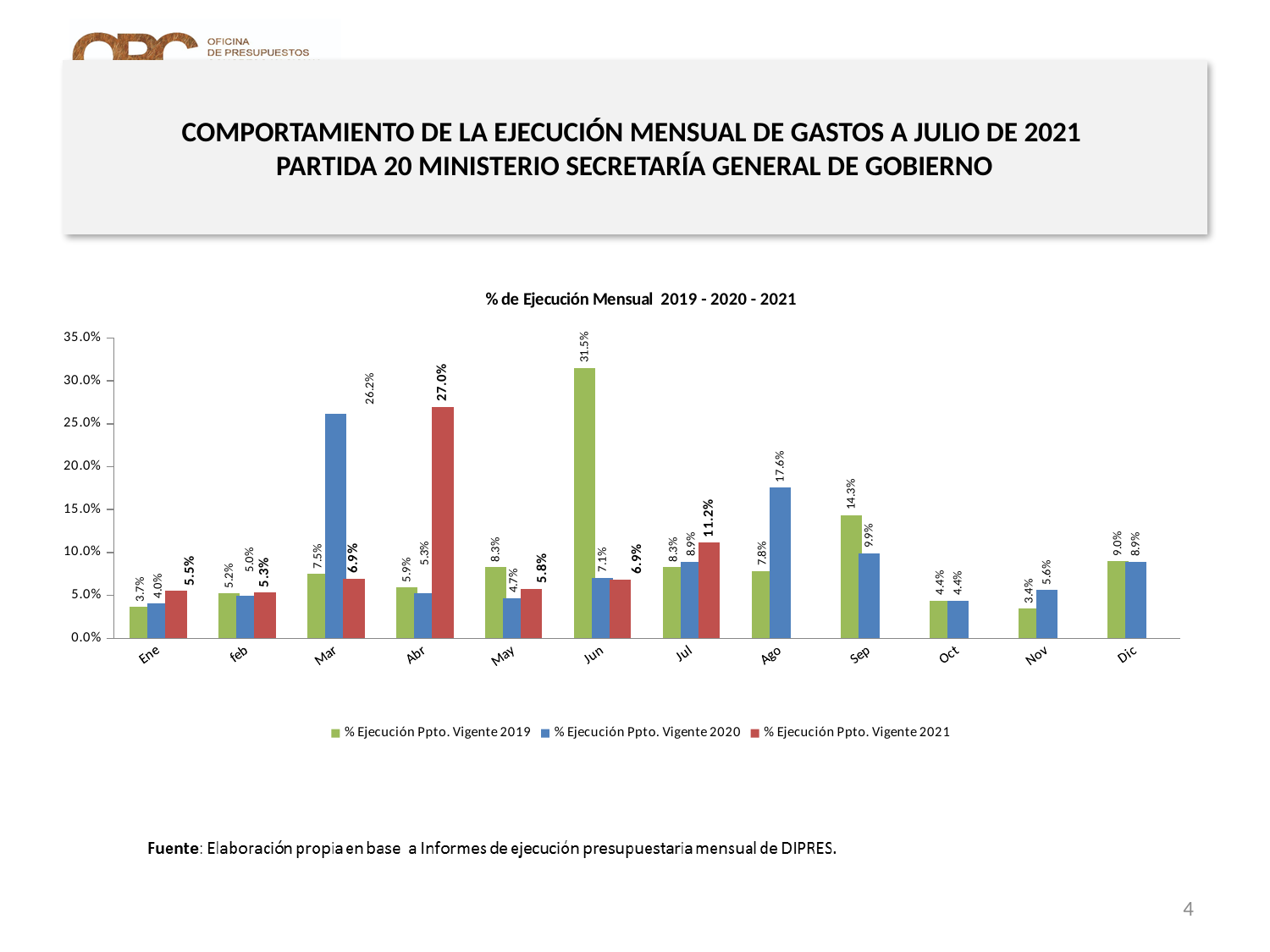
What is the value for % Ejecución Ppto. Vigente 2019 in Sep? 14.3% In which month is the % Ejecución Ppto. Vigente 2019 series lowest? Nov What is the value for % Ejecución Ppto. Vigente 2020 in Mar? 26.2% What is the value for % Ejecución Ppto. Vigente 2021 in Abr? 27.0% How many series does the legend list? 3 Which is larger in Jul: the 2021 value or the 2020 value? 2021 value (11.2%) What is the title of the chart? % de Ejecución Mensual 2019 - 2020 - 2021 What kind of chart is shown on the slide? Bar chart In which month is the % Ejecución Ppto. Vigente 2019 series highest? Jun What is the difference between the 2020 and 2019 values in Ago? 9.8% How many months are shown on the x axis? 12 Is the value for % Ejecución Ppto. Vigente 2019 in Jun greater or less than 30.0%? greater